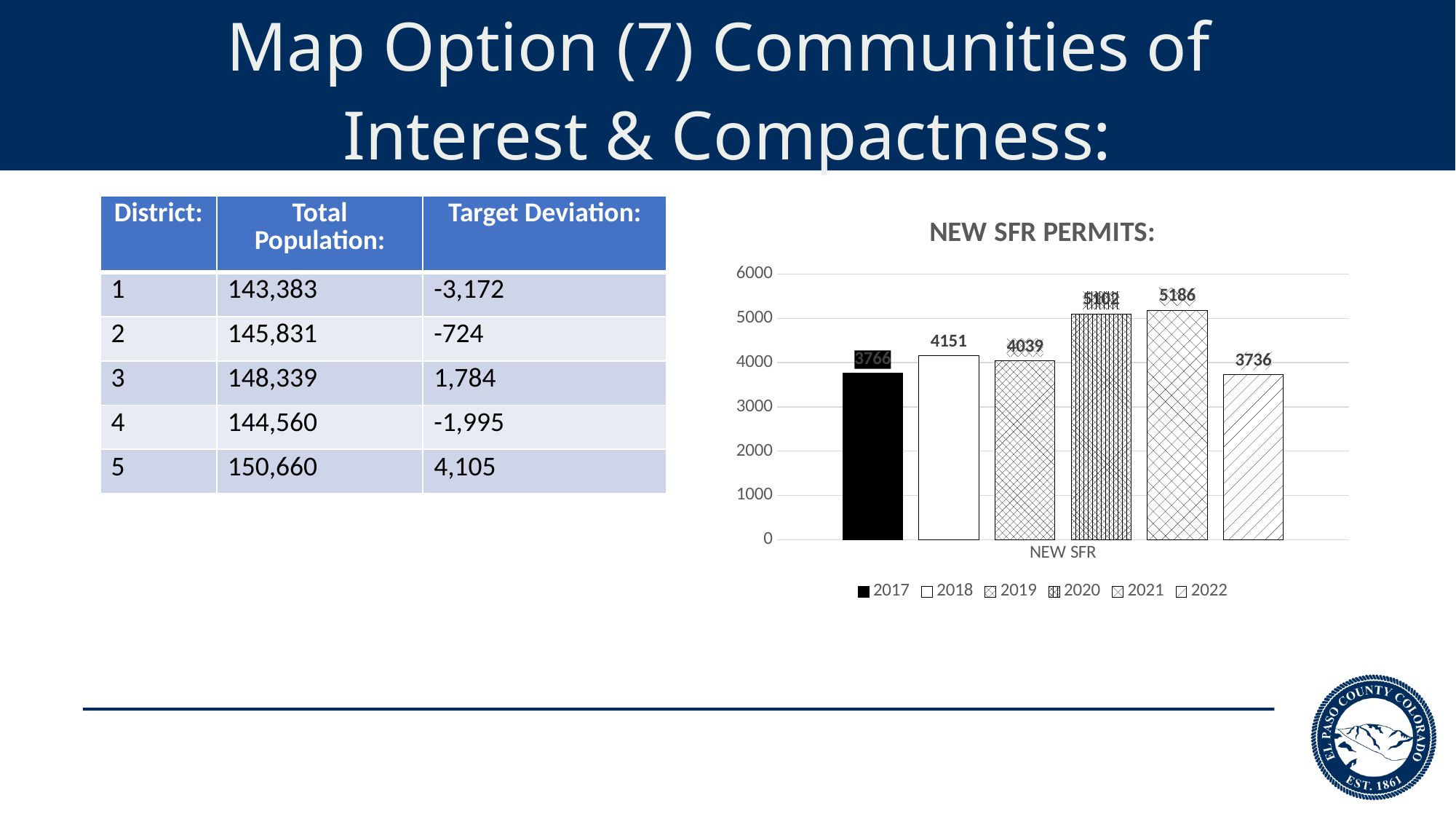
In the NEW SFR PERMITS chart, what is the value for 2017? 3766 In the NEW SFR PERMITS chart, what is the difference between the 2018 and 2019 values? 112 In the NEW SFR PERMITS chart, which is larger, the value for 2018 or the value for 2022? 2018 In the NEW SFR PERMITS chart, what is the value for 2019? 4039 In the NEW SFR PERMITS chart, is the value for 2020 greater or less than 5000? greater In the NEW SFR PERMITS chart, what is the value for 2022? 3736 What kind of chart is the NEW SFR PERMITS chart? bar chart In the NEW SFR PERMITS chart, what is the value for 2018? 4151 How many series does the legend of the NEW SFR PERMITS chart list? 6 In the NEW SFR PERMITS chart, what is the difference between the 2021 and 2022 values? 1450 What is the title of the chart on the right side of the slide? NEW SFR PERMITS: In the NEW SFR PERMITS chart, what is the value for 2021? 5186